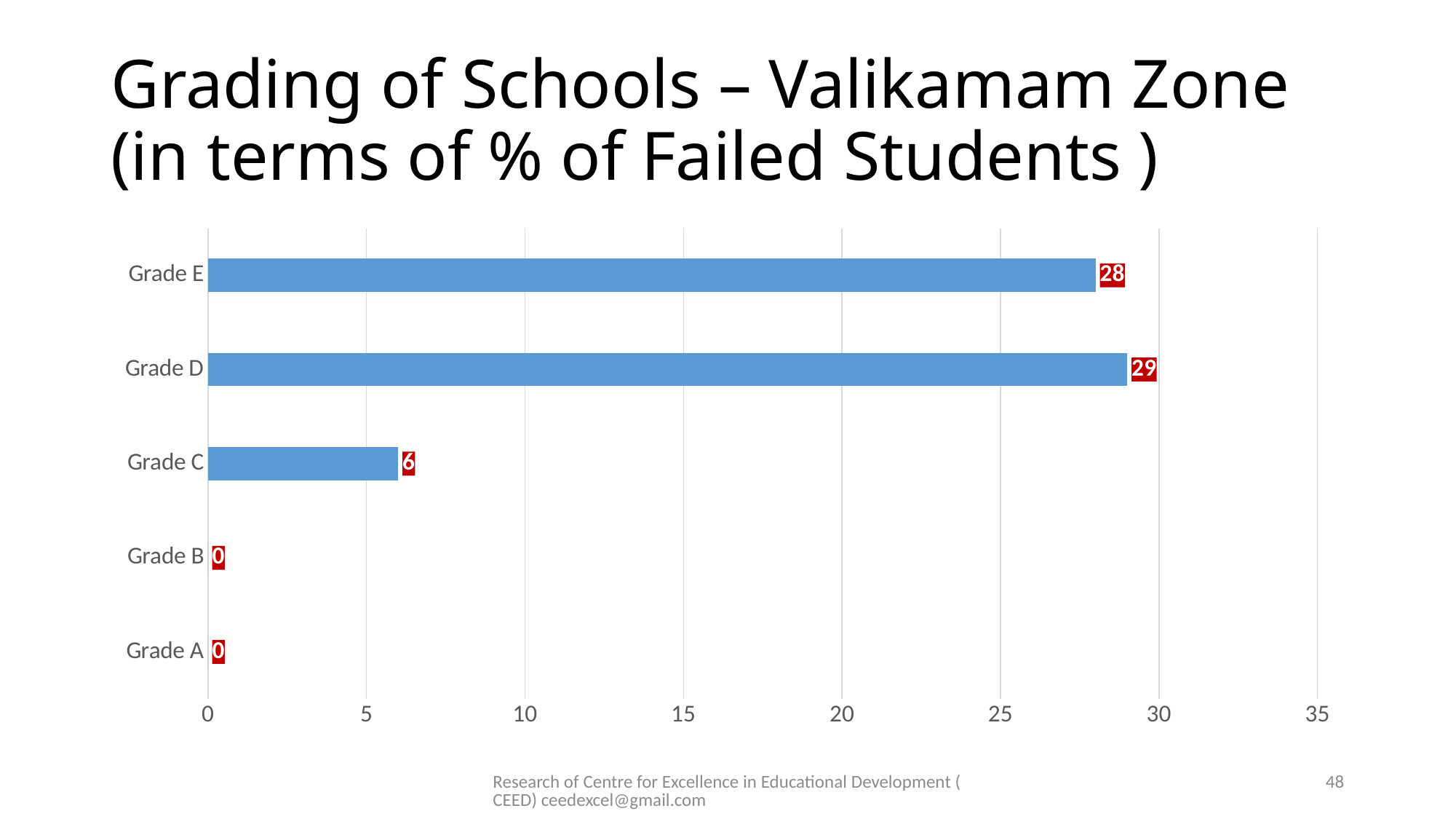
What is the value for Grade E? 28 What is the value for Grade D? 29 What is the difference between the values for Grade D and Grade C? 23 Which is larger, the value for Grade C or the value for Grade E? Grade E How many grade categories are shown in the chart? 5 What is the difference between the values for Grade D and Grade E? 1 What is the value for Grade C? 6 What is the value for Grade B? 0 Is the value for Grade E greater or less than 25? greater What kind of chart is shown on the slide? Bar chart What is the highest value shown on the horizontal axis? 35 Which grade has the highest value? Grade D